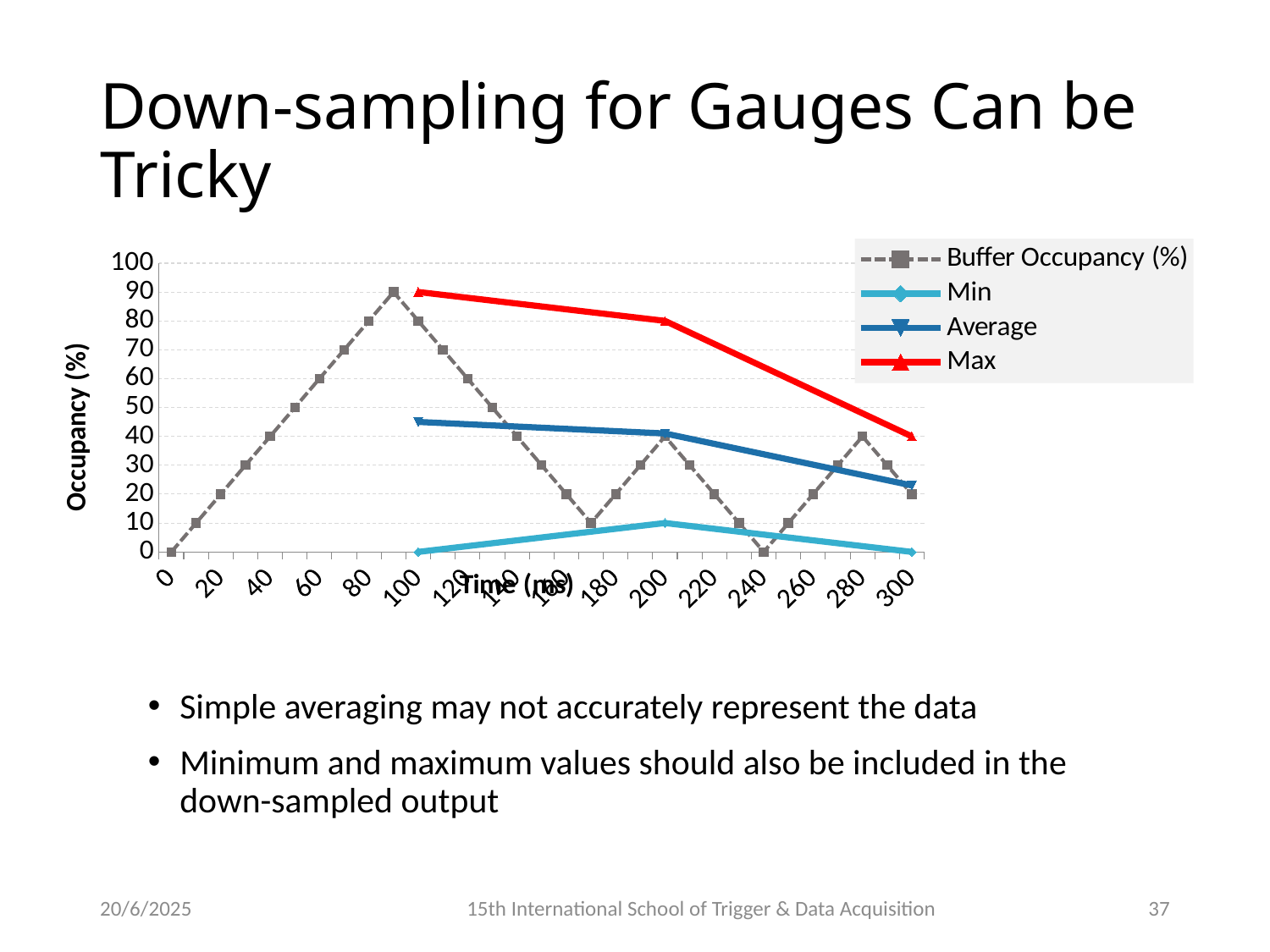
What kind of chart is shown on the slide? line chart Does the Max series rise or fall as time increases from 100 ms to 300 ms? fall What is the title of the vertical axis? Occupancy (%) How many data points does the Max series have? 3 What is the value of the Max series at 100 ms? 90 What is the value of the Min series at 200 ms? 10 What is the highest value reached by the Buffer Occupancy (%) series? 90 At 200 ms, which is larger: the Max series or the Average series? Max Is the value of the Average series at 100 ms greater or less than 40? greater Is the value of the Average series at 300 ms greater or less than 30? less How many series does the legend list? 4 What is the value of the Max series at 300 ms? 40